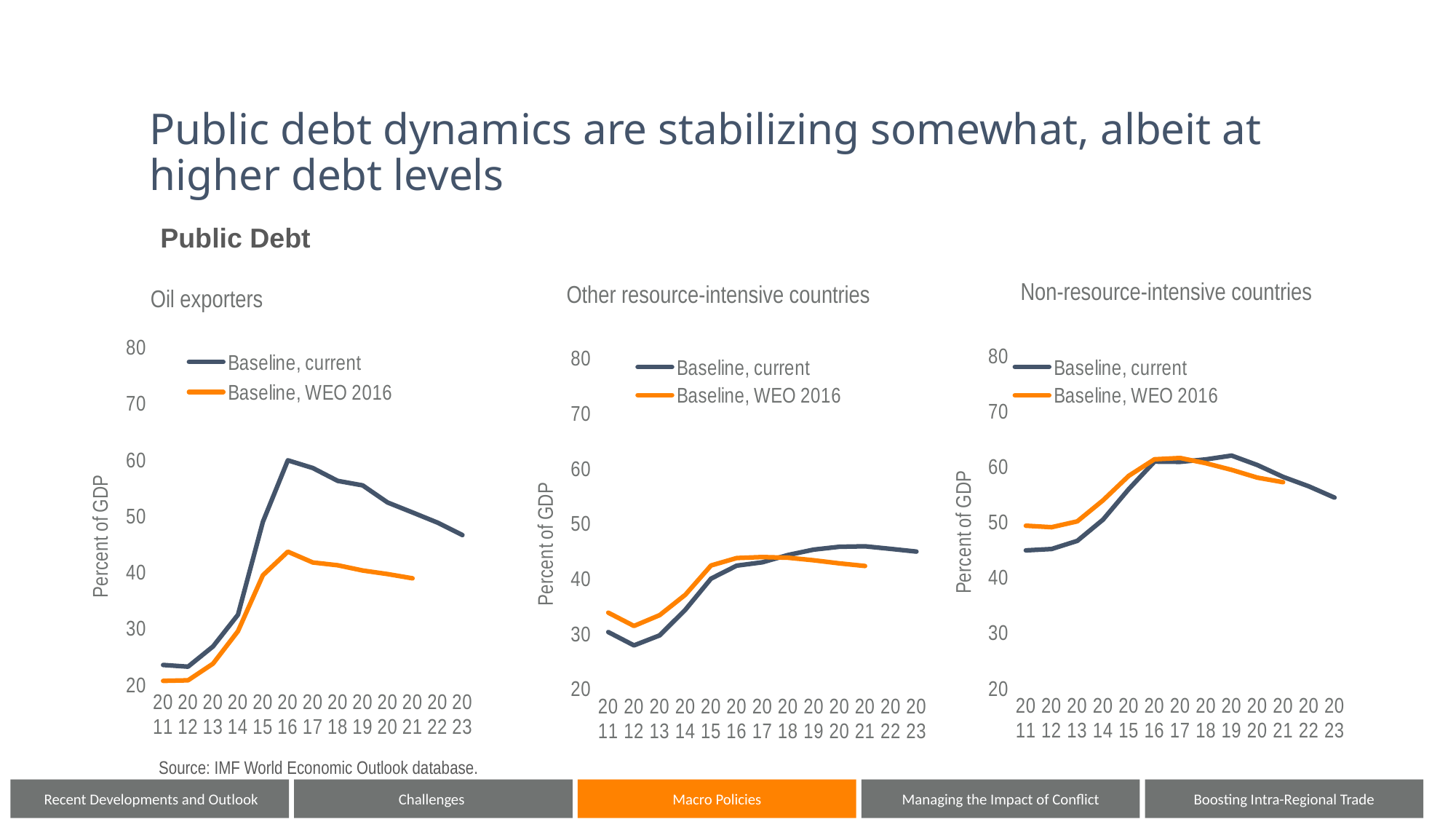
What is the y-axis label on the 'Non-resource-intensive countries' chart? Percent of GDP How many series does the legend of the 'Other resource-intensive countries' chart list? 2 In the 'Non-resource-intensive countries' chart, which series has the larger value in 2011, 'Baseline, current' or 'Baseline, WEO 2016'? Baseline, WEO 2016 In the 'Oil exporters' chart, in which year does the 'Baseline, current' series reach its highest value? 2016 In the 'Oil exporters' chart, which series has the larger value in 2016, 'Baseline, current' or 'Baseline, WEO 2016'? Baseline, current In the 'Oil exporters' chart, does the 'Baseline, current' series rise or fall from 2016 to 2023? fall What kind of chart is the 'Oil exporters' chart? line chart How many years are shown on the x axis of the 'Non-resource-intensive countries' chart? 13 In the 'Oil exporters' chart, is the 'Baseline, current' value for 2011 greater or less than 30? less In the 'Other resource-intensive countries' chart, in which year is the 'Baseline, current' series at its lowest? 2012 In the 'Oil exporters' chart, is the 'Baseline, current' value for 2016 greater or less than 50? greater In the 'Other resource-intensive countries' chart, is the 'Baseline, current' value for 2023 greater or less than 40? greater